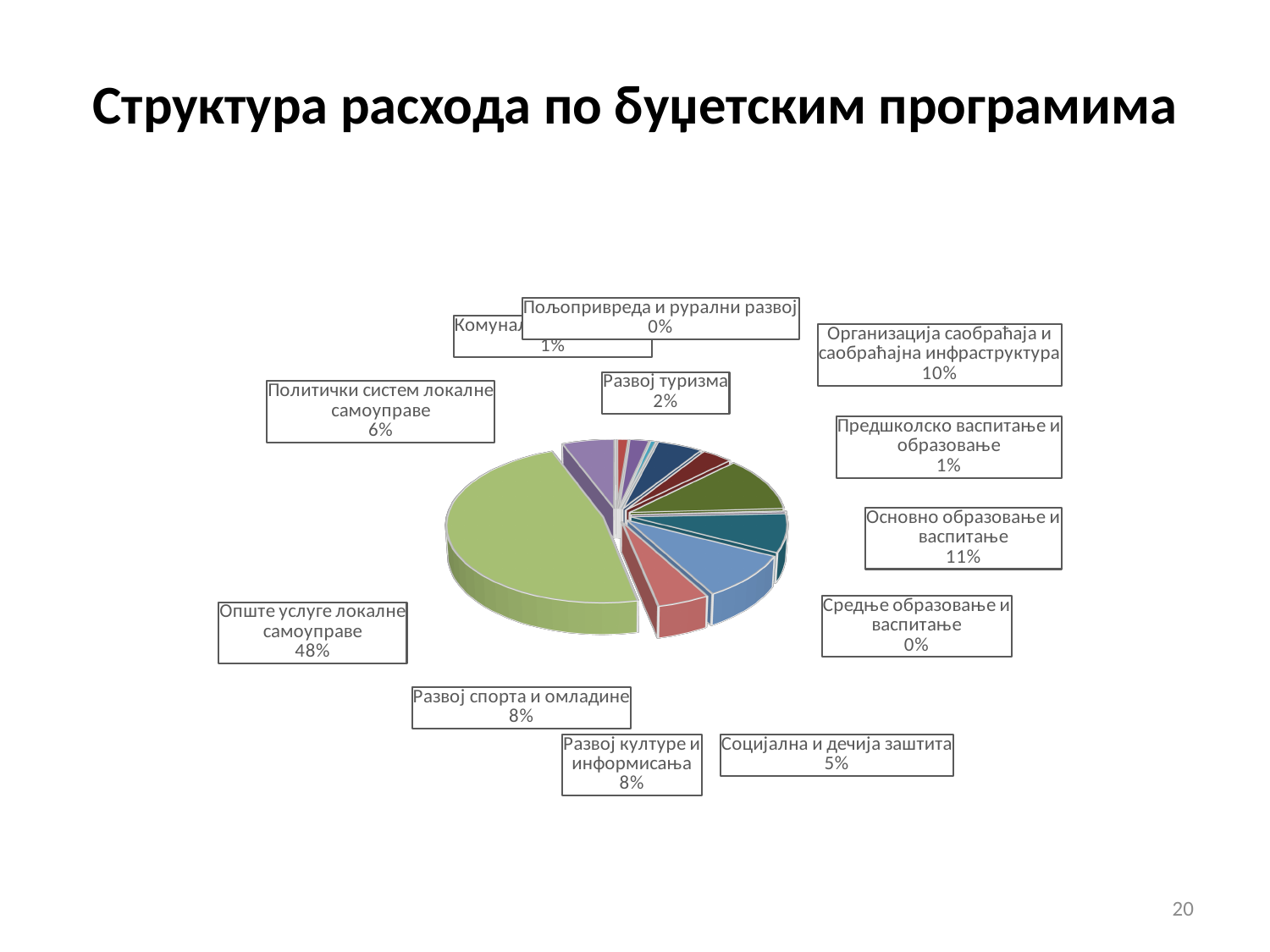
What share of the pie does Опште услуге локалне самоуправе have? 48% What percentage is shown for Организација саобраћаја и саобраћајна инфраструктура? 10% Which category has the largest share of the pie? Опште услуге локалне самоуправе How many categories are labelled on the pie chart? 12 What kind of chart is shown on the slide? pie chart What percentage is shown for Социјална и дечија заштита? 5% What percentage is shown for Основно образовање и васпитање? 11% What percentage is shown for Политички систем локалне самоуправе? 6% Which is larger, the share for Развој спорта и омладине or the share for Социјална и дечија заштита? Развој спорта и омладине What is the title of the chart on the slide? Структура расхода по буџетским програмима What percentage is shown for Развој туризма? 2% What is the difference in percentage points between Опште услуге локалне самоуправе and Основно образовање и васпитање? 37